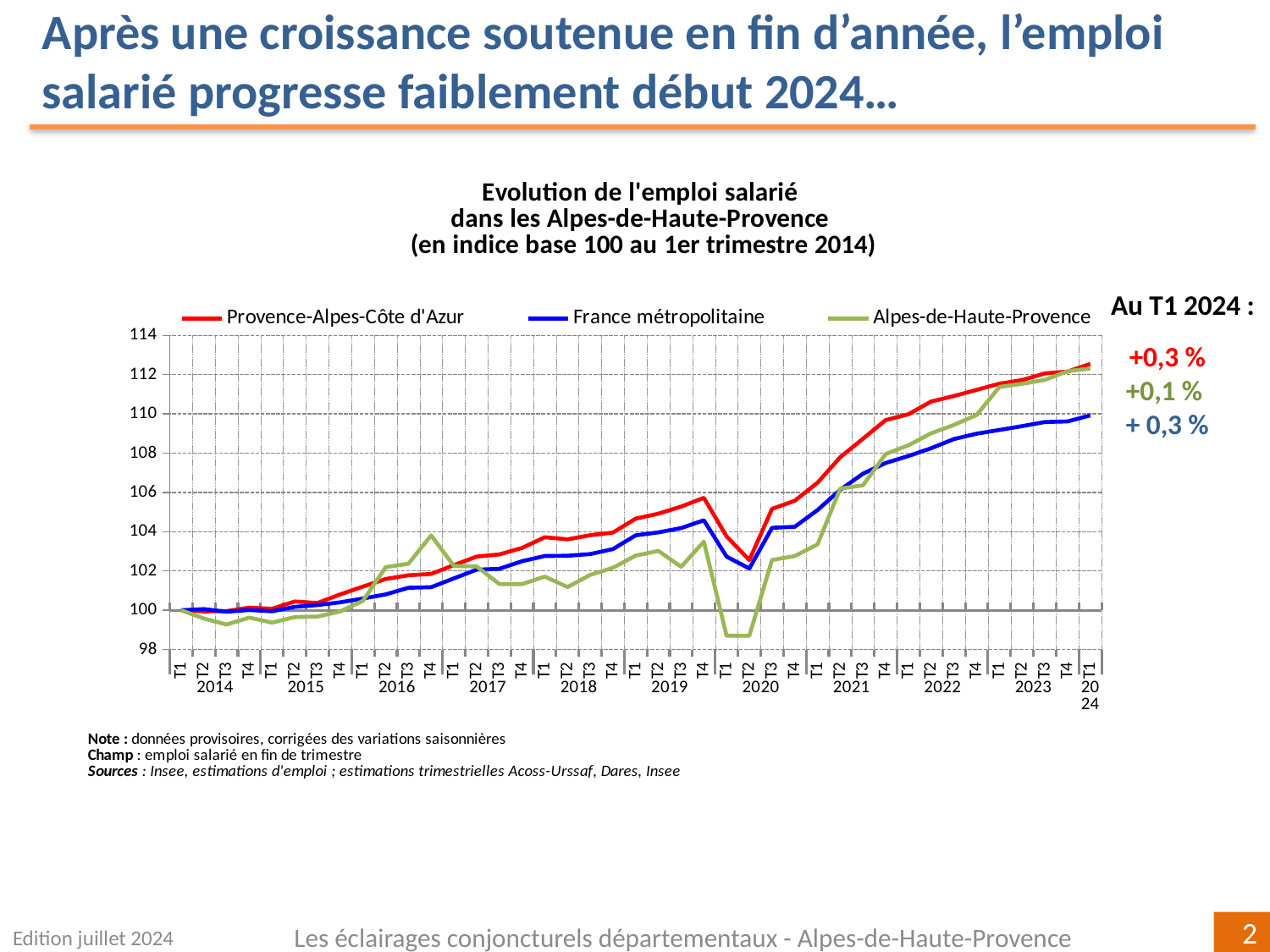
Which series has the highest value at T4 2016? Alpes-de-Haute-Provence What is the index value of all three series at T1 2014? 100 According to the annotation 'Au T1 2024', what is the change shown for Alpes-de-Haute-Provence (green)? +0,1 % Is the value for Provence-Alpes-Côte d'Azur at T1 2024 greater or less than 110? greater At T1 2024, which is higher: Provence-Alpes-Côte d'Azur or France métropolitaine? Provence-Alpes-Côte d'Azur Is the value for Alpes-de-Haute-Provence at T1 2020 greater or less than 100? less Is the value for France métropolitaine at T1 2024 greater or less than 108? greater Which three series are listed in the chart legend? Provence-Alpes-Côte d'Azur, France métropolitaine, Alpes-de-Haute-Provence What kind of chart is shown on the slide? Line chart How many series does the legend of the chart list? 3 Which series has the lowest value at T1 2020? Alpes-de-Haute-Provence Overall, do the series rise or fall between T1 2014 and T1 2024? rise